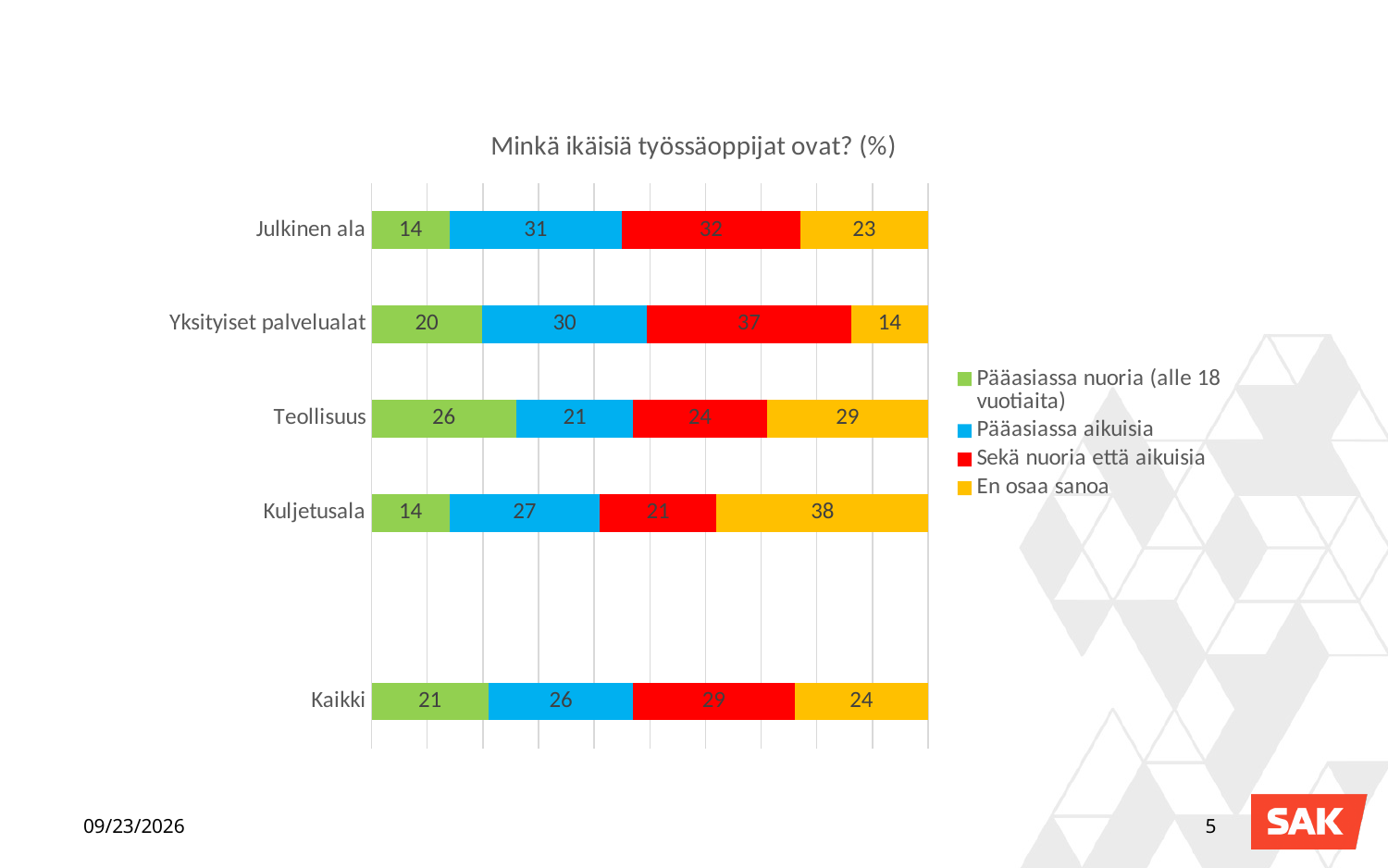
How many series does the legend list? 4 What is the title of the chart? Minkä ikäisiä työssäoppijat ovat? (%) What is the value for "Pääasiassa nuoria (alle 18 vuotiaita)" in the Kaikki bar? 21 What is the value for "En osaa sanoa" in the Kuljetusala bar? 38 Which is larger: the "Pääasiassa aikuisia" value for Yksityiset palvelualat or for Teollisuus? Yksityiset palvelualat Which category has the lowest value for "En osaa sanoa"? Yksityiset palvelualat What is the value for "Sekä nuoria että aikuisia" in the Yksityiset palvelualat bar? 37 What is the value for "Pääasiassa aikuisia" in the Julkinen ala bar? 31 How many categories are shown on the vertical axis? 5 What is the difference between the "En osaa sanoa" values for Kuljetusala and Julkinen ala? 15 What kind of chart is shown on the slide? Stacked bar chart Which category has the highest value for "Pääasiassa nuoria (alle 18 vuotiaita)"? Teollisuus